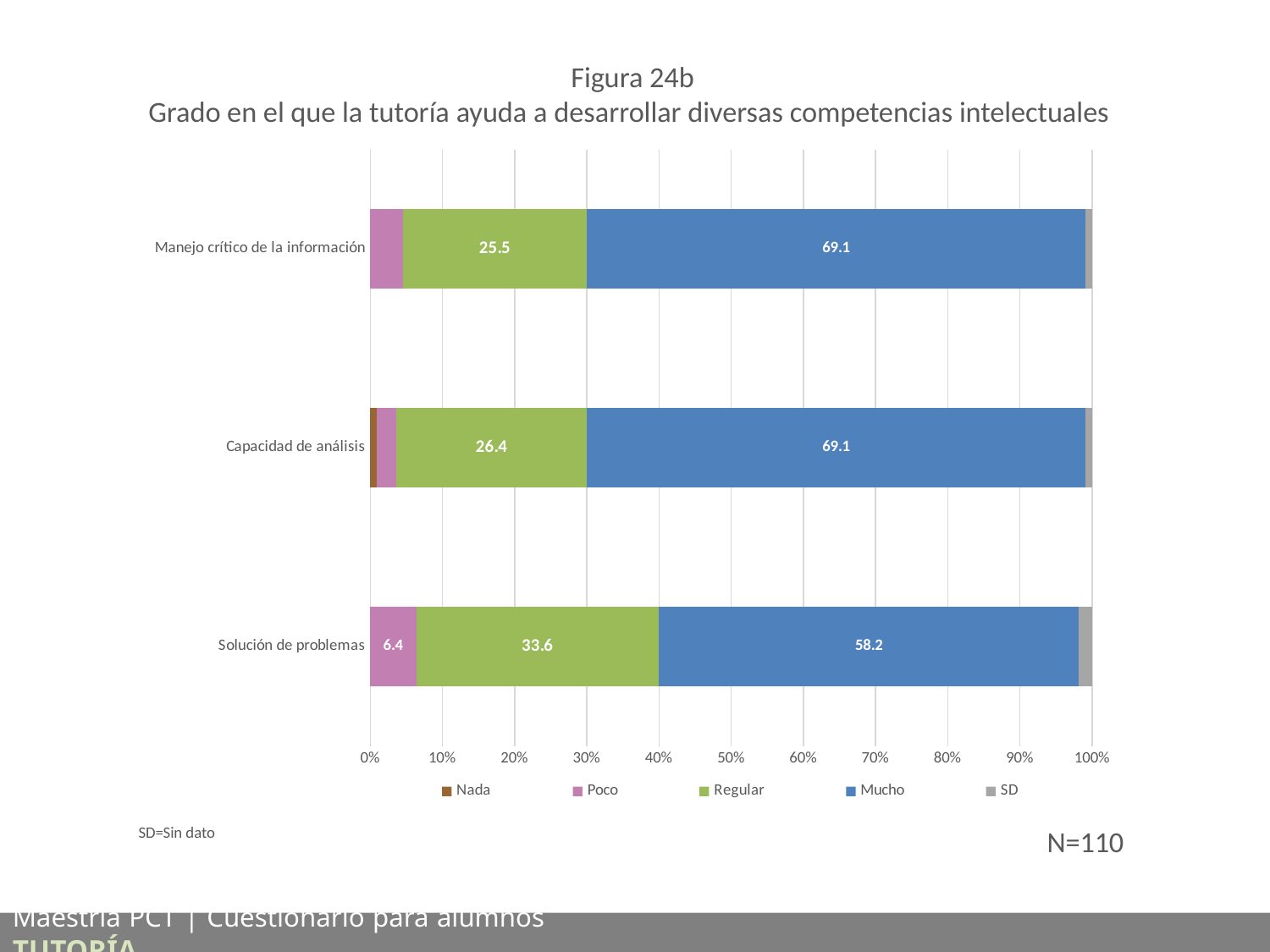
What is the difference between the Regular values for Solución de problemas and Manejo crítico de la información? 8.1 Which is larger: the Regular value for Capacidad de análisis or the Regular value for Manejo crítico de la información? Capacidad de análisis Which category has the highest value for the Regular series? Solución de problemas How many categories are shown on the chart? 3 What is the value of the Mucho segment for Solución de problemas? 58.2 What kind of chart is shown on the slide? Stacked bar chart What is the value of the Regular segment for Manejo crítico de la información? 25.5 How many series does the legend list? 5 Is the Poco segment for Manejo crítico de la información greater or less than 10%? less What is the value of the Poco segment for Solución de problemas? 6.4 What is the difference between the Mucho values for Capacidad de análisis and Solución de problemas? 10.9 Which category has the lowest value for the Mucho series? Solución de problemas